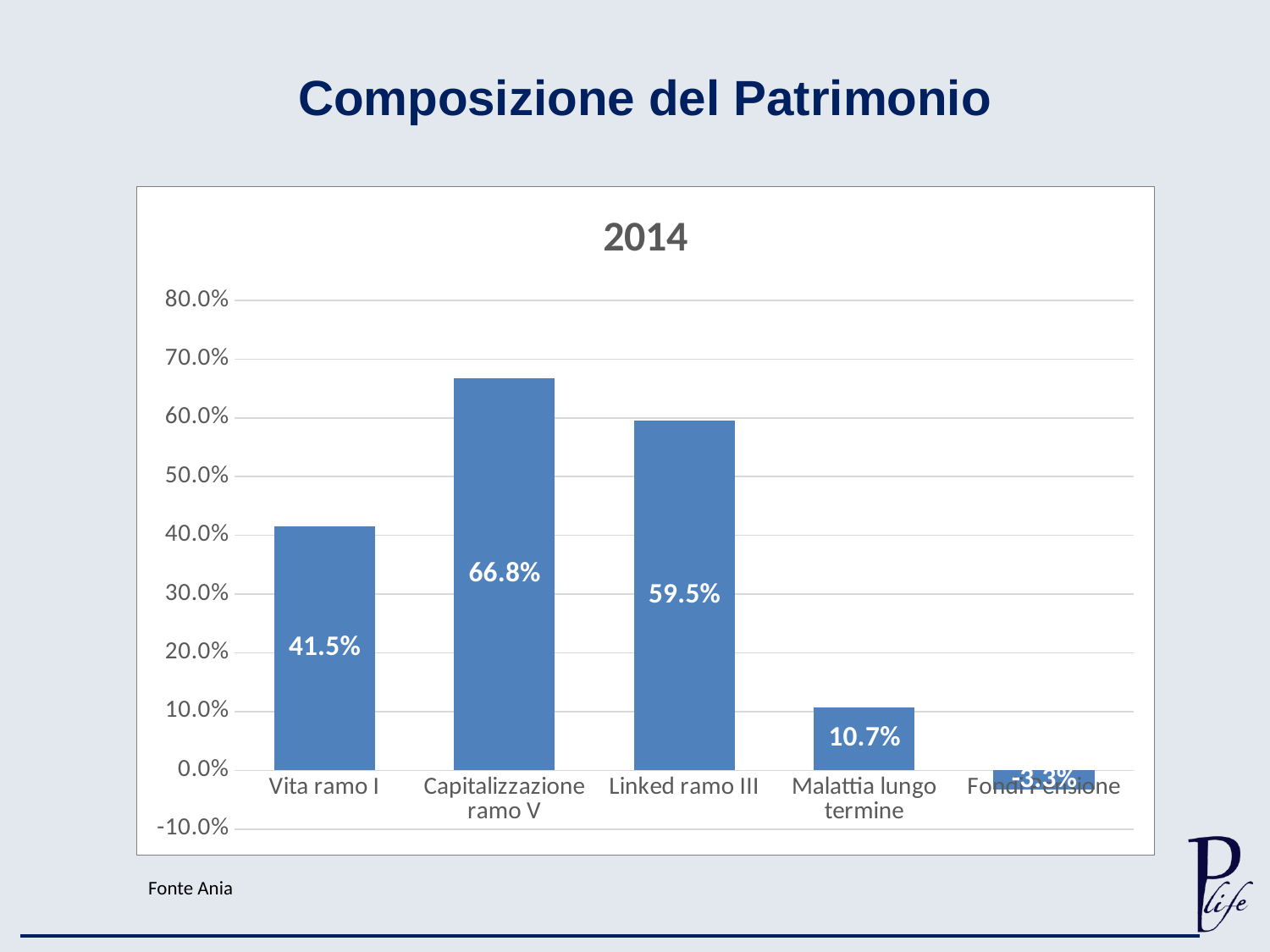
What type of chart is shown on the slide? bar chart What is the difference between the values for Vita ramo I and Malattia lungo termine? 30.8 percentage points What is the value for Linked ramo III? 59.5% How many categories are shown on the x axis? 5 What is the difference between the values for Capitalizzazione ramo V and Linked ramo III? 7.3 percentage points What is the value for Malattia lungo termine? 10.7% Which is larger, the value for Vita ramo I or the value for Linked ramo III? Linked ramo III What is the value for Capitalizzazione ramo V? 66.8% Which category has the lowest value? Fondi Pensione Which category has the highest value? Capitalizzazione ramo V Is the value for Malattia lungo termine greater or less than 20.0%? less What is the value for Vita ramo I? 41.5%